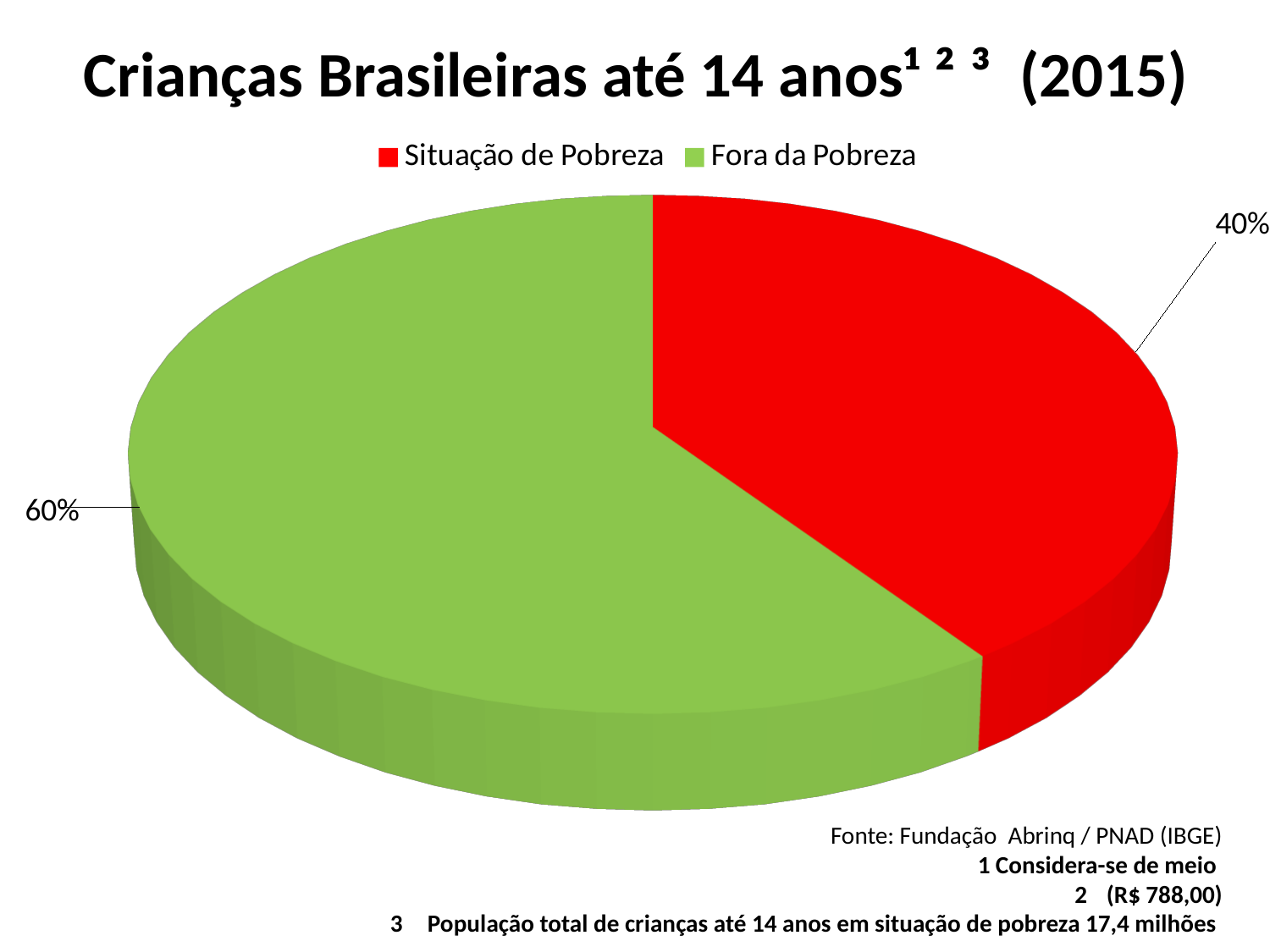
What is the title of the chart? Crianças Brasileiras até 14 anos (2015) What share of the pie is labelled for Fora da Pobreza? 60% What colour is the Situação de Pobreza slice? red How many entries does the legend list? 2 What kind of chart is shown on the slide? pie chart How many slices does the pie chart have? 2 Which slice is the largest? Fora da Pobreza Which is larger, Situação de Pobreza or Fora da Pobreza? Fora da Pobreza What share of the pie is labelled for Situação de Pobreza? 40% What is the difference in percentage points between Fora da Pobreza and Situação de Pobreza? 20% Which slice is the smallest? Situação de Pobreza